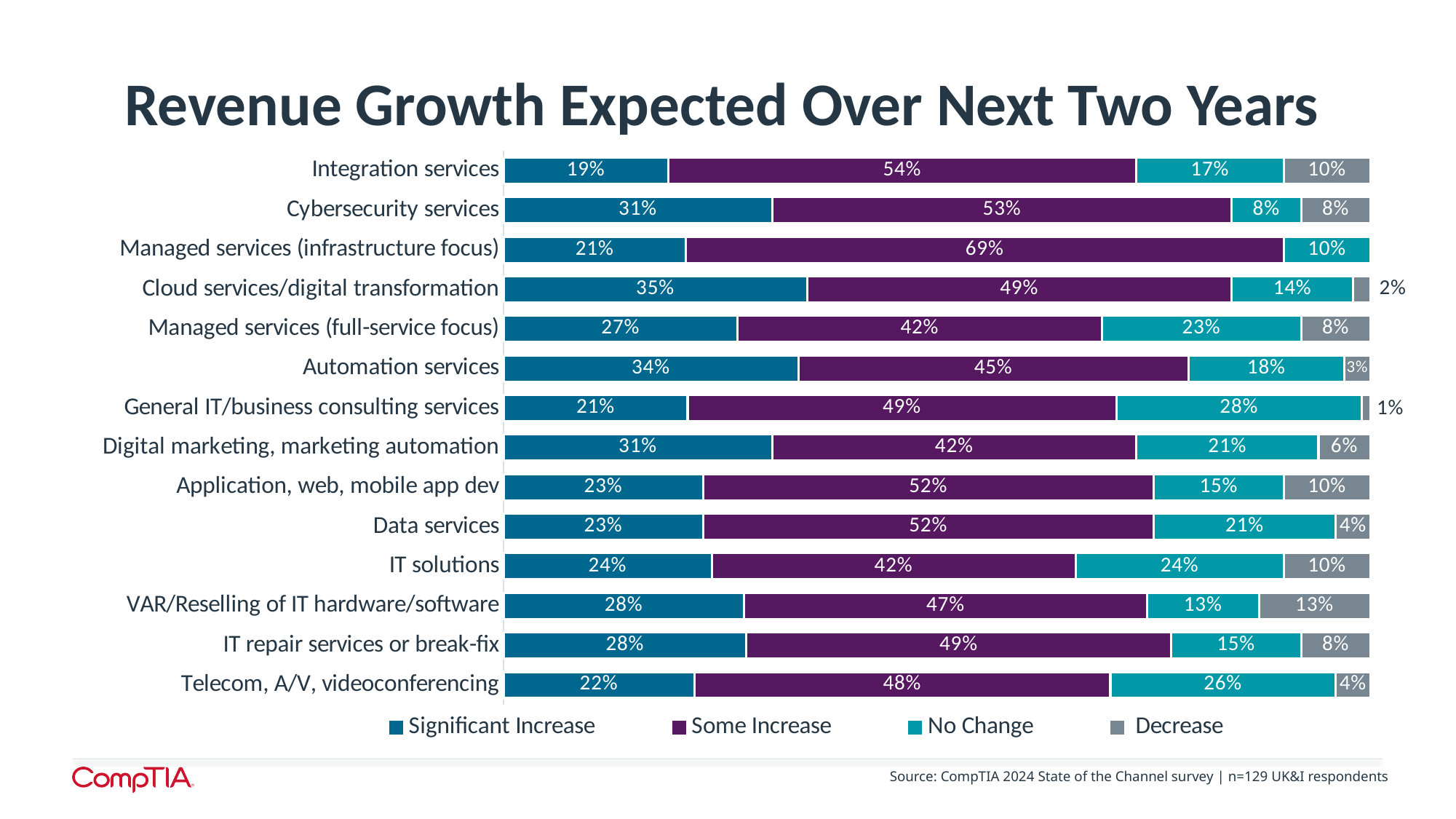
How many series does the legend list? 4 What is the Some Increase value for Managed services (infrastructure focus)? 69% Which category has the lowest Significant Increase value? Integration services Which category has the highest Significant Increase value? Cloud services/digital transformation What is the Decrease value for VAR/Reselling of IT hardware/software? 13% Which category has the highest Some Increase value? Managed services (infrastructure focus) What type of chart is shown on the slide? Stacked bar chart How many service categories are plotted in the chart? 14 What is the Significant Increase value for Cybersecurity services? 31% What is the difference between the Significant Increase values for Cybersecurity services and Integration services? 12 percentage points What is the No Change value for Telecom, A/V, videoconferencing? 26% Which is larger: the No Change value for General IT/business consulting services or for Application, web, mobile app dev? General IT/business consulting services